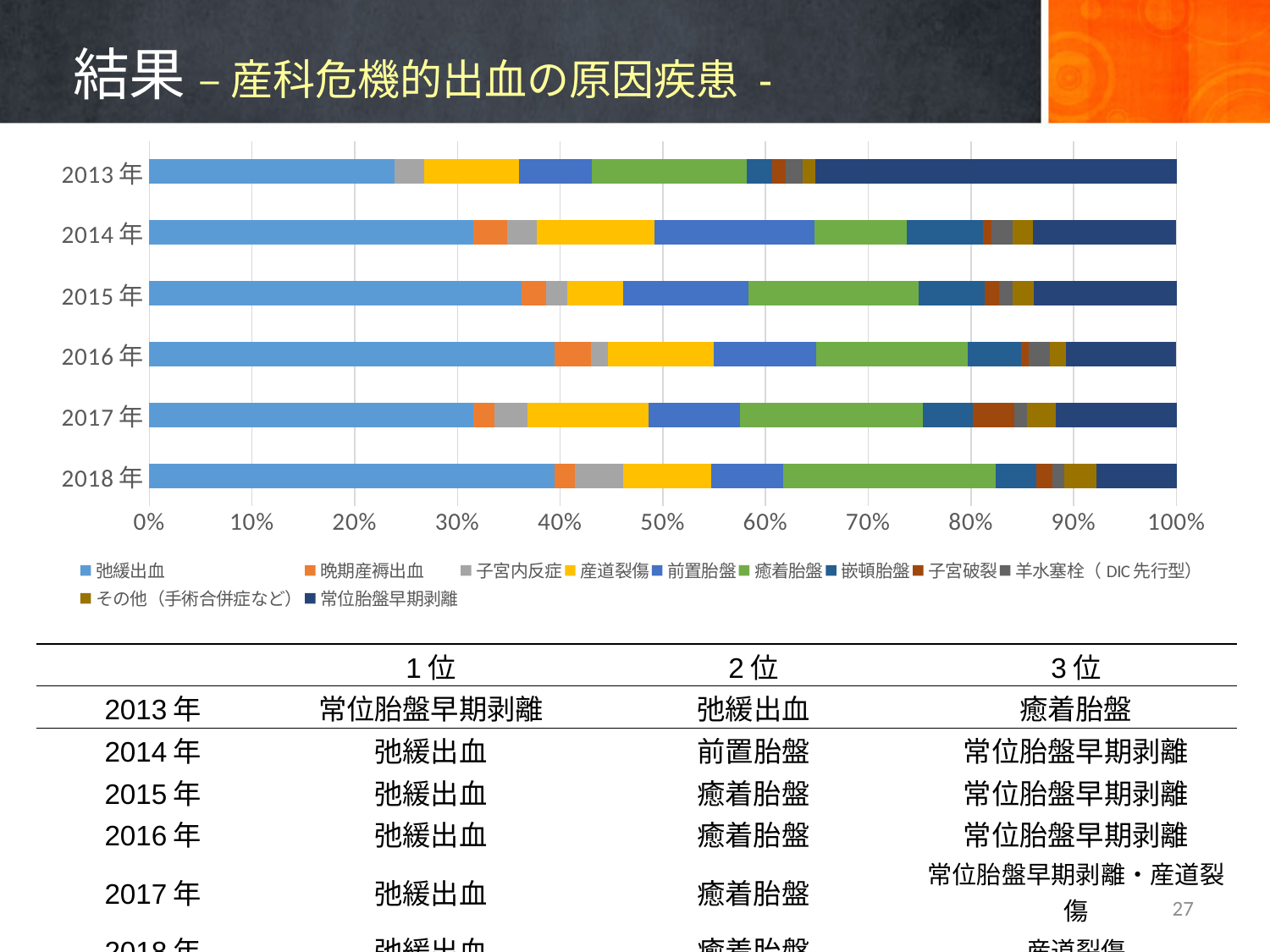
What is the first series listed in the chart legend? 弛緩出血 How many series does the chart legend list? 11 Is the share of 弛緩出血 in 2016年 greater or less than 30%? greater Which is larger, the share of 弛緩出血 in 2013年 or in 2018年? 2018年 Which year has the smallest share of 弛緩出血? 2013年 Is the share of 常位胎盤早期剥離 in 2013年 greater or less than 30%? greater How many years (categories) are plotted in the chart? 6 Which year has the largest share of 常位胎盤早期剥離? 2013年 Is the share of 常位胎盤早期剥離 in 2018年 greater or less than 10%? less What kind of chart is shown on the slide? stacked bar chart